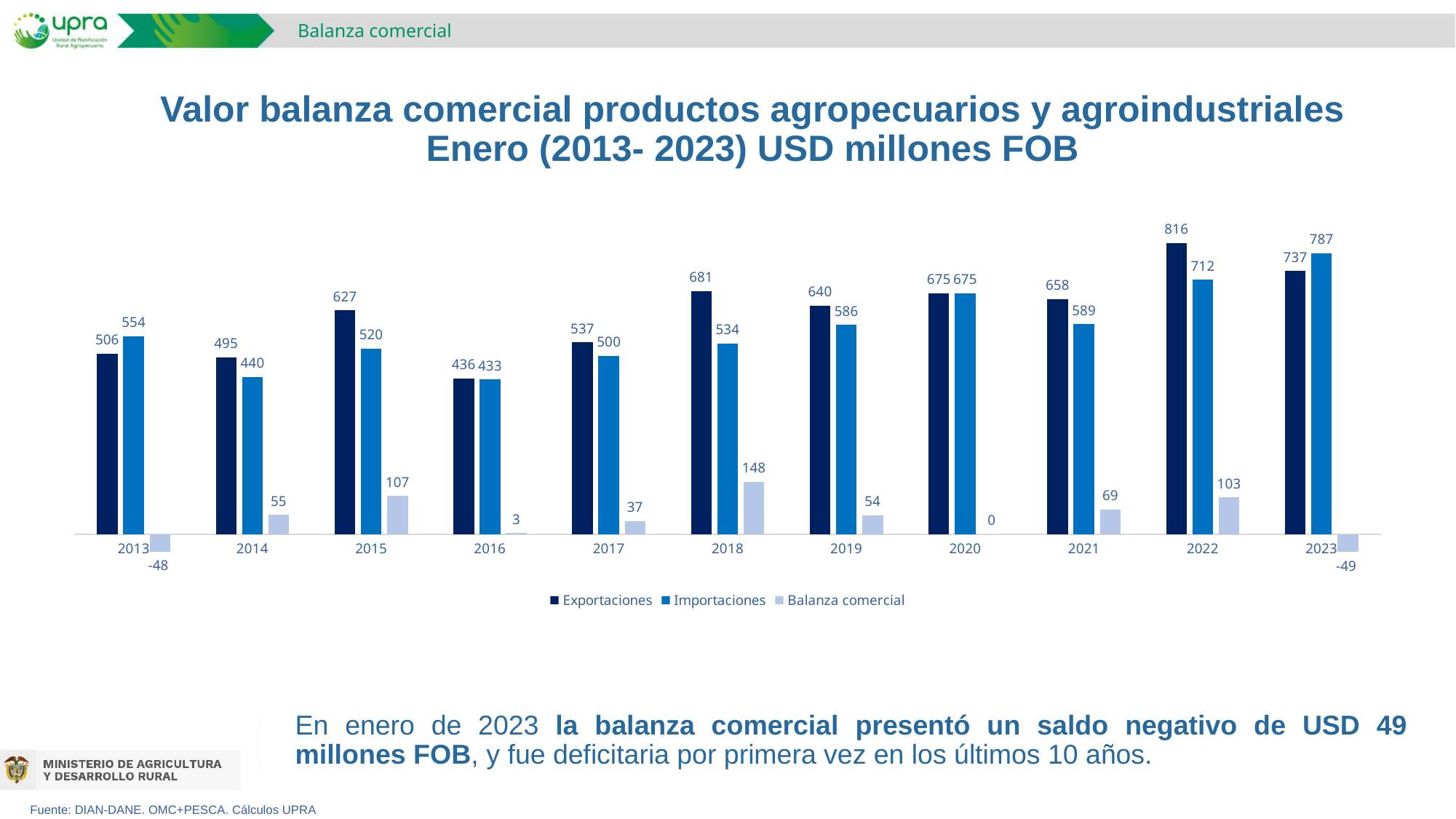
Which was larger in 2023, Exportaciones or Importaciones? Importaciones In which year were Importaciones lowest? 2016 What is the difference between Exportaciones and Importaciones in 2014? 55 What was the Balanza comercial value in 2018? 148 How many series does the legend list? 3 What kind of chart is shown on the slide? Bar chart What is the third series listed in the legend? Balanza comercial How many years are shown on the x axis? 11 What was the value of Importaciones in 2022? 712 In which year were Exportaciones highest? 2022 What was the Balanza comercial value in 2020? 0 What was the value of Exportaciones in 2015? 627